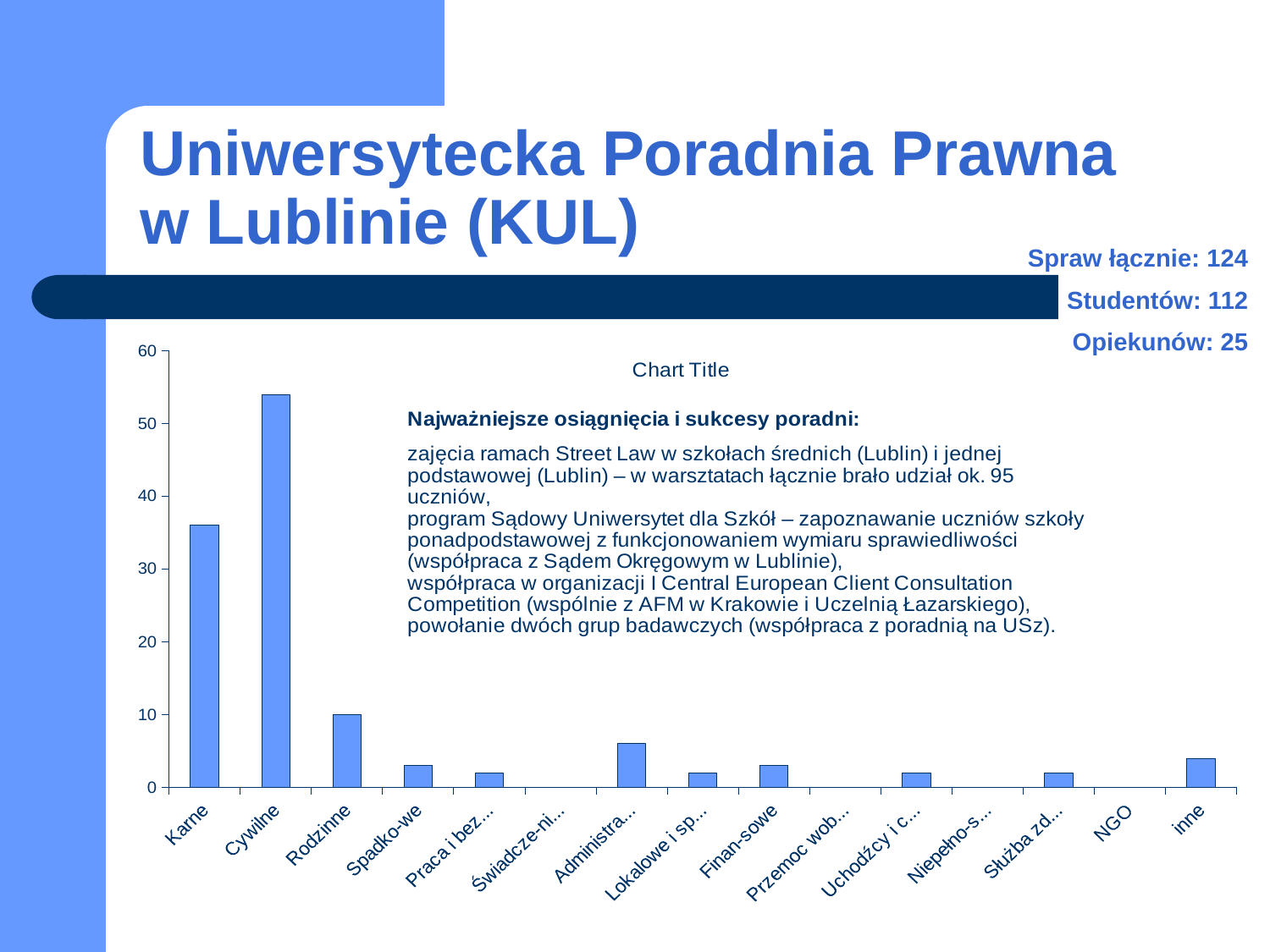
Is the value for Karne greater or less than 30? greater Is the value for Karne greater or less than 40? less Which category has the highest bar in the chart? Cywilne Which is larger, the value for Karne or the value for Cywilne? Cywilne Is the value for Rodzinne greater or less than 20? less What is the title shown on the chart? Chart Title Which is larger, the value for Administra... or the value for Spadko-we? Administra... What kind of chart is shown on the slide? bar chart Which is larger, the value for Rodzinne or the value for Administra...? Rodzinne How many categories are shown on the x axis of the chart? 15